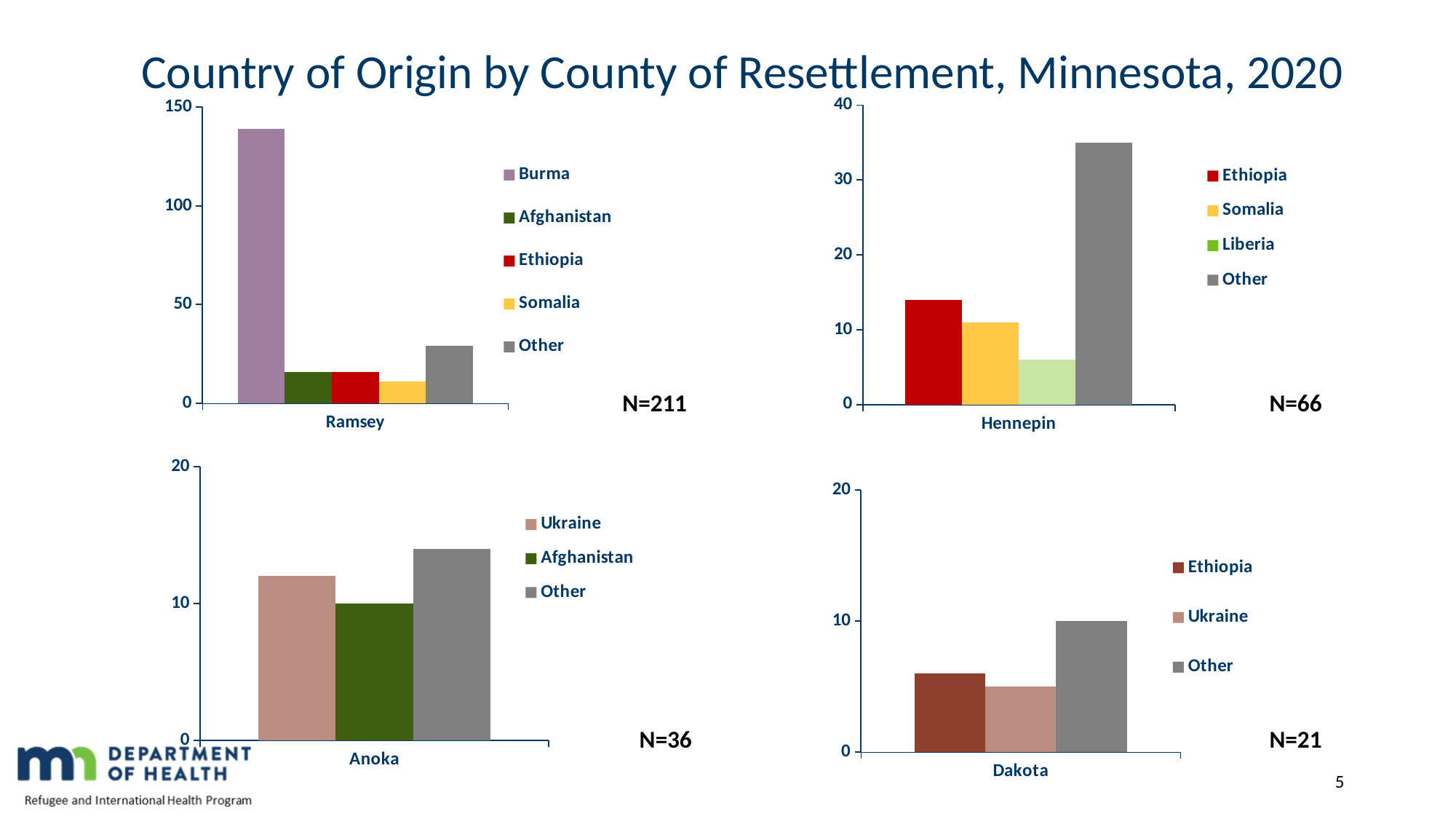
In the Hennepin chart, is the value for Other greater or less than 30? greater In the Hennepin chart, is the value for Ethiopia greater or less than 10? greater How many series does the legend of the Ramsey chart list? 5 In the Ramsey chart, is the value for Burma greater or less than 100? greater In the Anoka chart, which is larger, Ukraine or Afghanistan? Ukraine In the Dakota chart, which category has the highest value? Other In the Hennepin chart, which country has the lowest value? Liberia How many series does the legend of the Hennepin chart list? 4 In the Hennepin chart, which category has the highest value? Other What kind of chart is the Ramsey chart? bar chart In the Ramsey chart, which country has the highest value? Burma